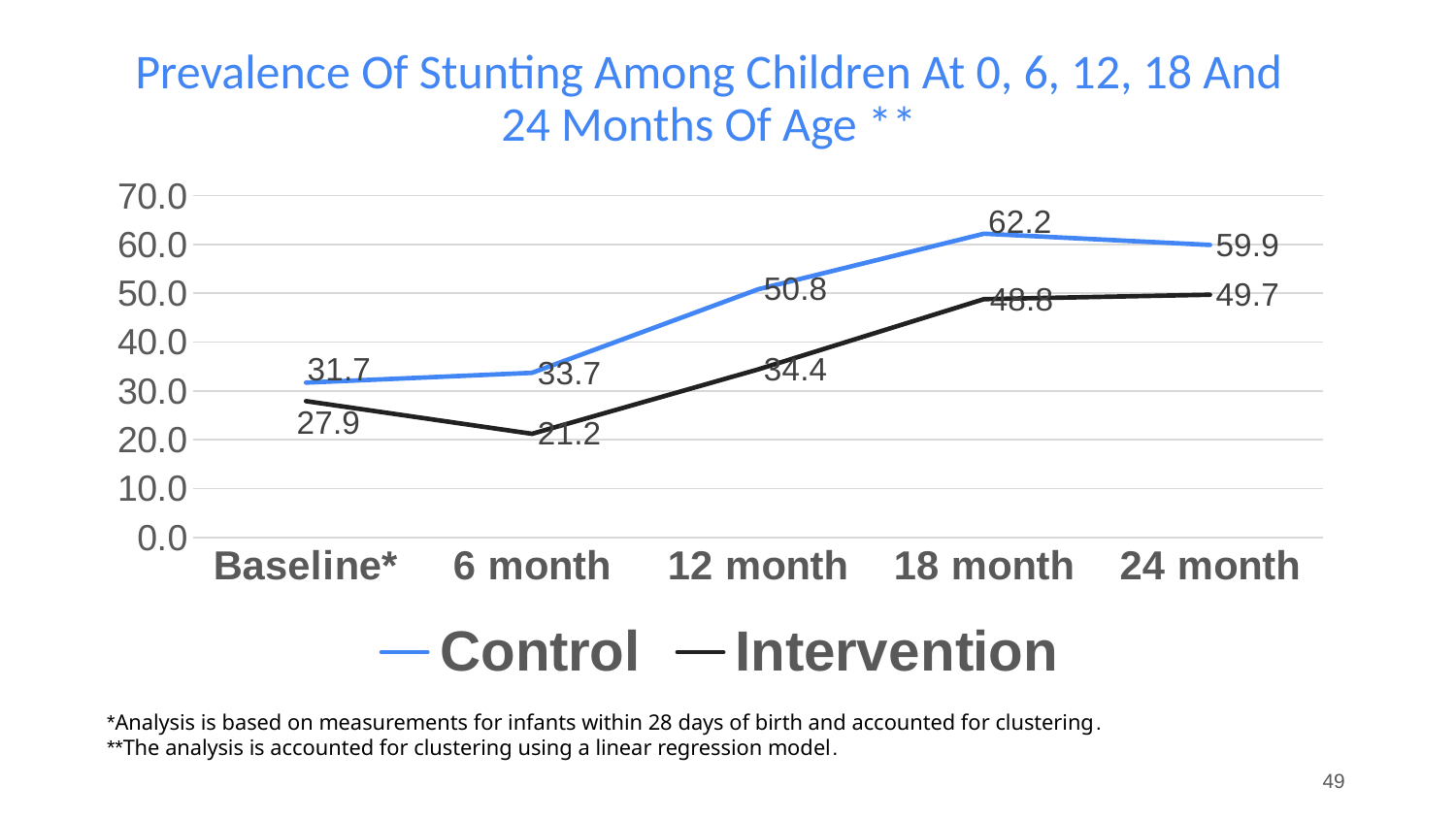
At which time point is the Control series highest? 18 month What is the Control value at 12 month? 50.8 Which series has the larger value at 12 month, Control or Intervention? Control At which time point is the Intervention series lowest? 6 month How many series does the legend list? 2 How many time points are shown on the x axis? 5 What is the Intervention value at 6 month? 21.2 What is the Control value at Baseline*? 31.7 What is the Intervention value at 24 month? 49.7 What is the difference between the Control and Intervention values at 24 month? 10.2 What is the difference between the Control values at 18 month and 24 month? 2.3 What kind of chart is shown on the slide? Line chart